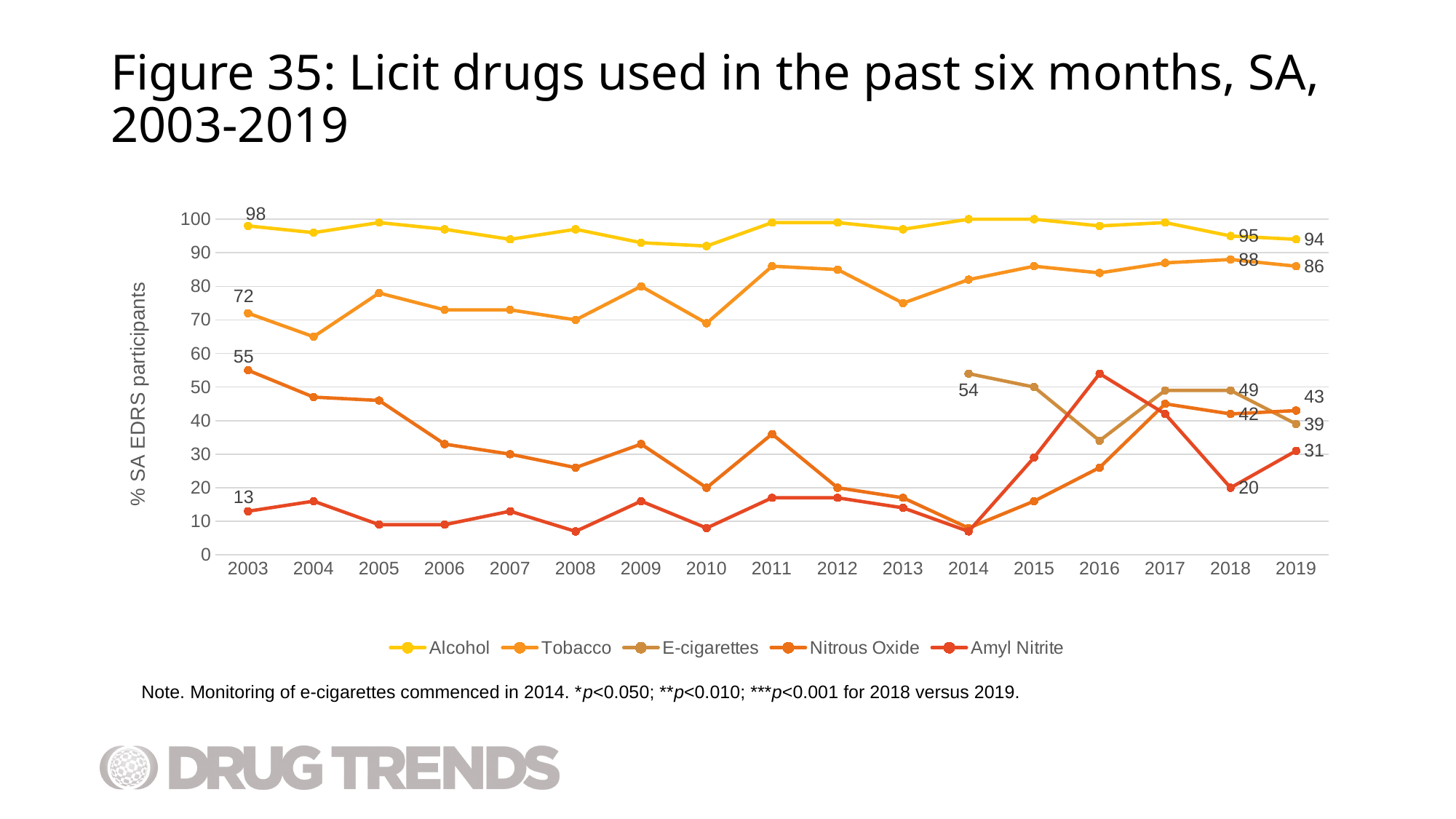
What kind of chart is shown on the slide? Line chart What was the value for Amyl Nitrite in 2018? 20 What was the value for Alcohol in 2003? 98 What was the value for Nitrous Oxide in 2019? 43 Is the value for Tobacco in 2011 greater or less than 80? greater Which series has the highest value in 2019? Alcohol How many years are shown on the x axis? 17 What was the value for Tobacco in 2019? 86 What was the value for E-cigarettes in 2014? 54 How many series does the legend list? 5 What is the difference between the Tobacco values in 2019 and 2003? 14 Which is larger in 2019, the value for Nitrous Oxide or the value for E-cigarettes? Nitrous Oxide